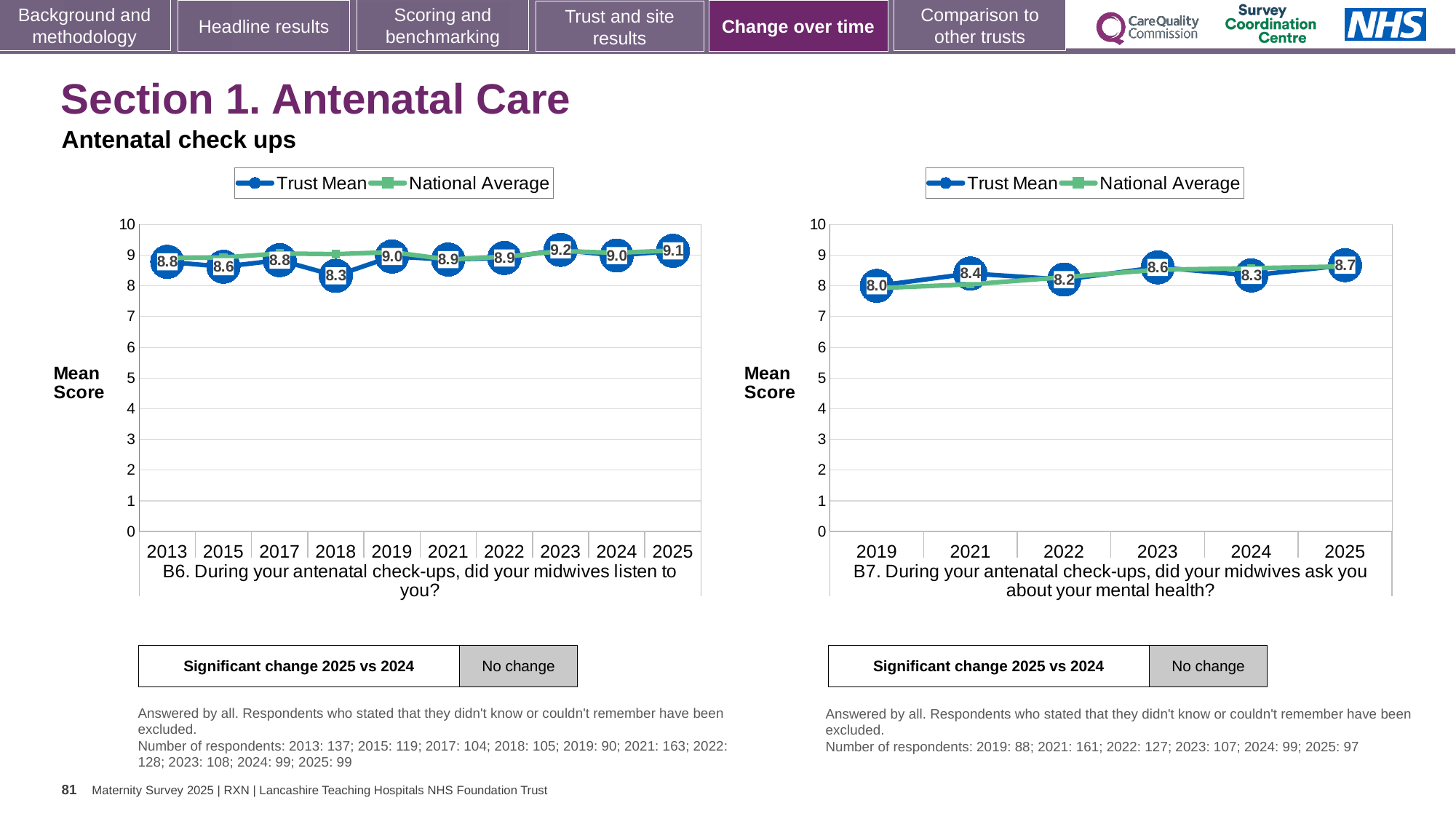
In the B6 chart (left), how many years are plotted on the x axis? 10 In the B7 chart (right), how many series does the legend list? 2 In the B6 chart (left), what is the Trust Mean score for 2025? 9.1 In the B7 chart (right), which year has the lowest Trust Mean score? 2019 In the B6 chart (left), which year has the highest Trust Mean score? 2023 In the B6 chart (left), which year has the lowest Trust Mean score? 2018 In the B7 chart (right), is the Trust Mean score for 2024 larger or smaller than the score for 2023? smaller In the B7 chart (right), which year has the highest Trust Mean score? 2025 In the B6 chart (left), what is the difference between the Trust Mean scores for 2023 and 2018? 0.9 In the B6 chart (left), what is the Trust Mean score for 2018? 8.3 In the B7 chart (right), what is the Trust Mean score for 2021? 8.4 What kind of chart is the B6 chart on the left? line chart